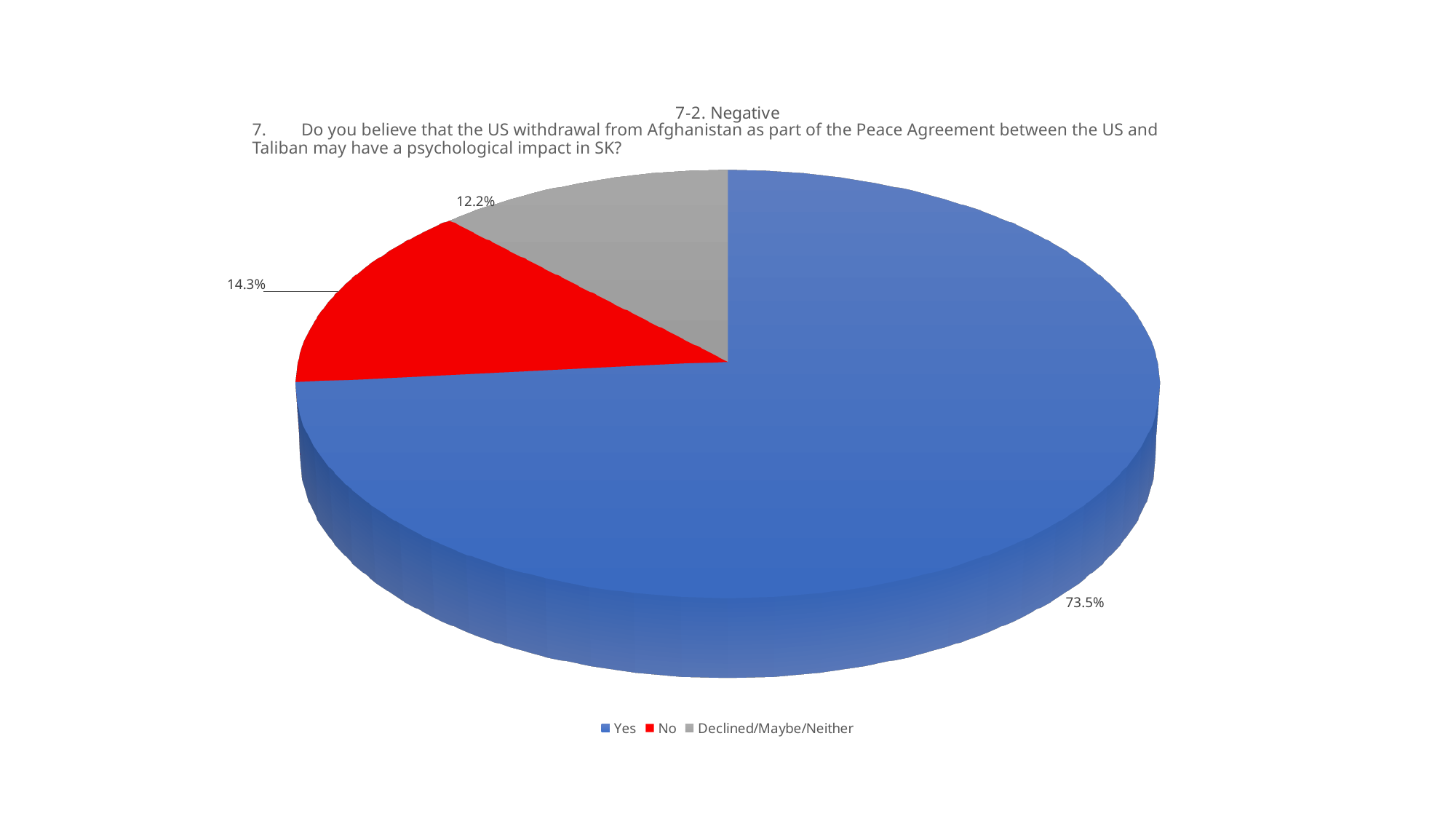
What is the difference in percentage points between the Yes slice and the No slice? 59.2 What kind of chart is shown on the slide? Pie chart What colour is the Yes slice in the pie chart? Blue What is the difference in percentage points between the No slice and the Declined/Maybe/Neither slice? 2.1 Which is larger, the No slice or the Declined/Maybe/Neither slice? No What share of the pie does the Yes slice represent? 73.5% What share of the pie does the No slice represent? 14.3% What share of the pie does the Declined/Maybe/Neither slice represent? 12.2% Which category has the largest slice of the pie? Yes Which category has the smallest slice of the pie? Declined/Maybe/Neither How many slices does the pie chart have? 3 What is the title of the chart? 7-2. Negative